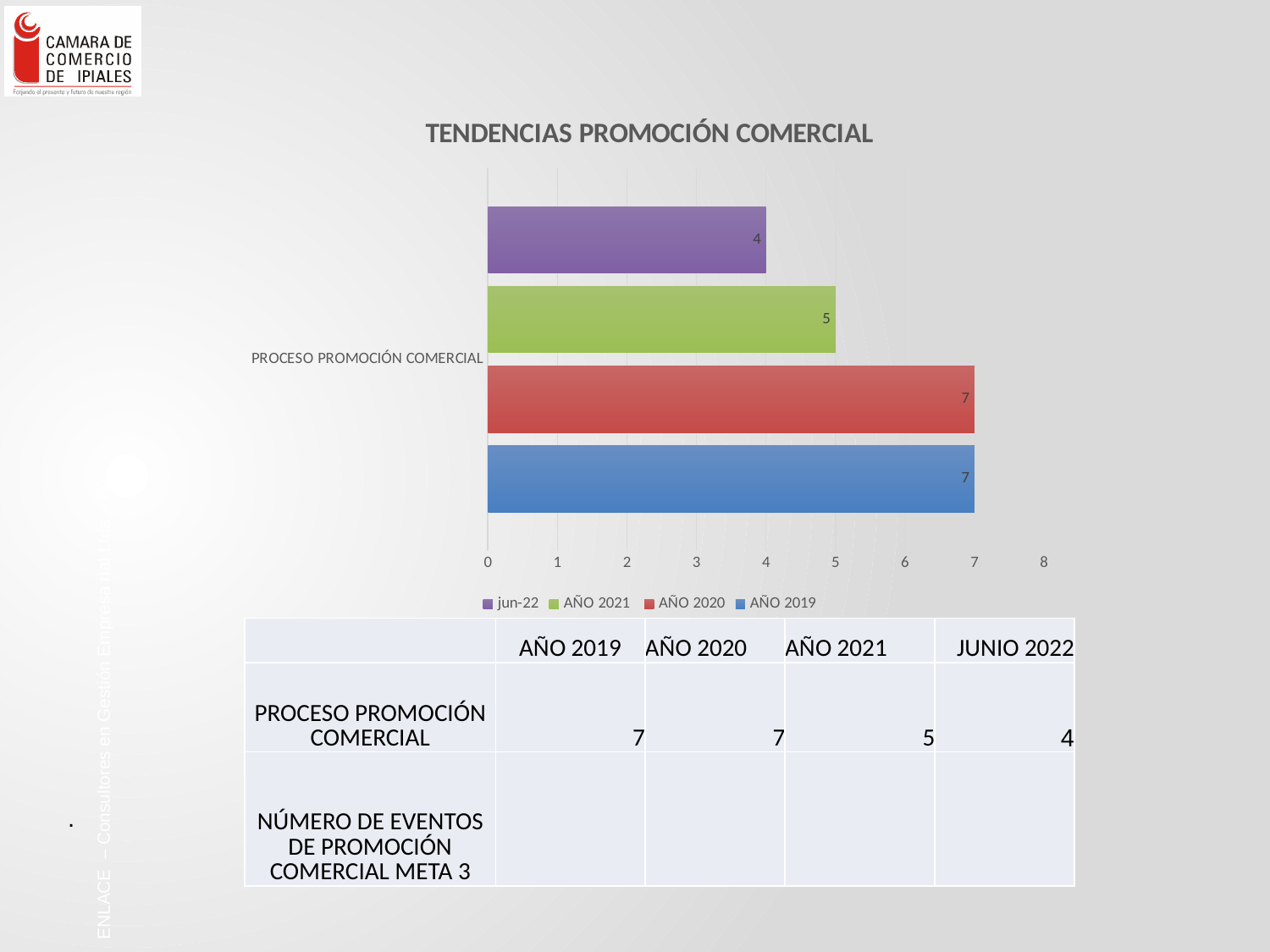
What kind of chart is shown on the slide? bar chart What is the value for AÑO 2020 in the chart? 7 Which series has the lowest value in the chart? jun-22 How many series does the legend list? 4 Do the values rise or fall from AÑO 2019 through AÑO 2021 to jun-22? fall What is the value for AÑO 2019 in the chart? 7 What is the difference between the AÑO 2021 value and the jun-22 value? 1 What is the difference between the AÑO 2019 value and the jun-22 value? 3 What is the value for AÑO 2021 in the chart? 5 What is the title of the chart? TENDENCIAS PROMOCIÓN COMERCIAL What is the value for jun-22 in the chart? 4 Which is larger, the value for AÑO 2020 or the value for AÑO 2021? AÑO 2020